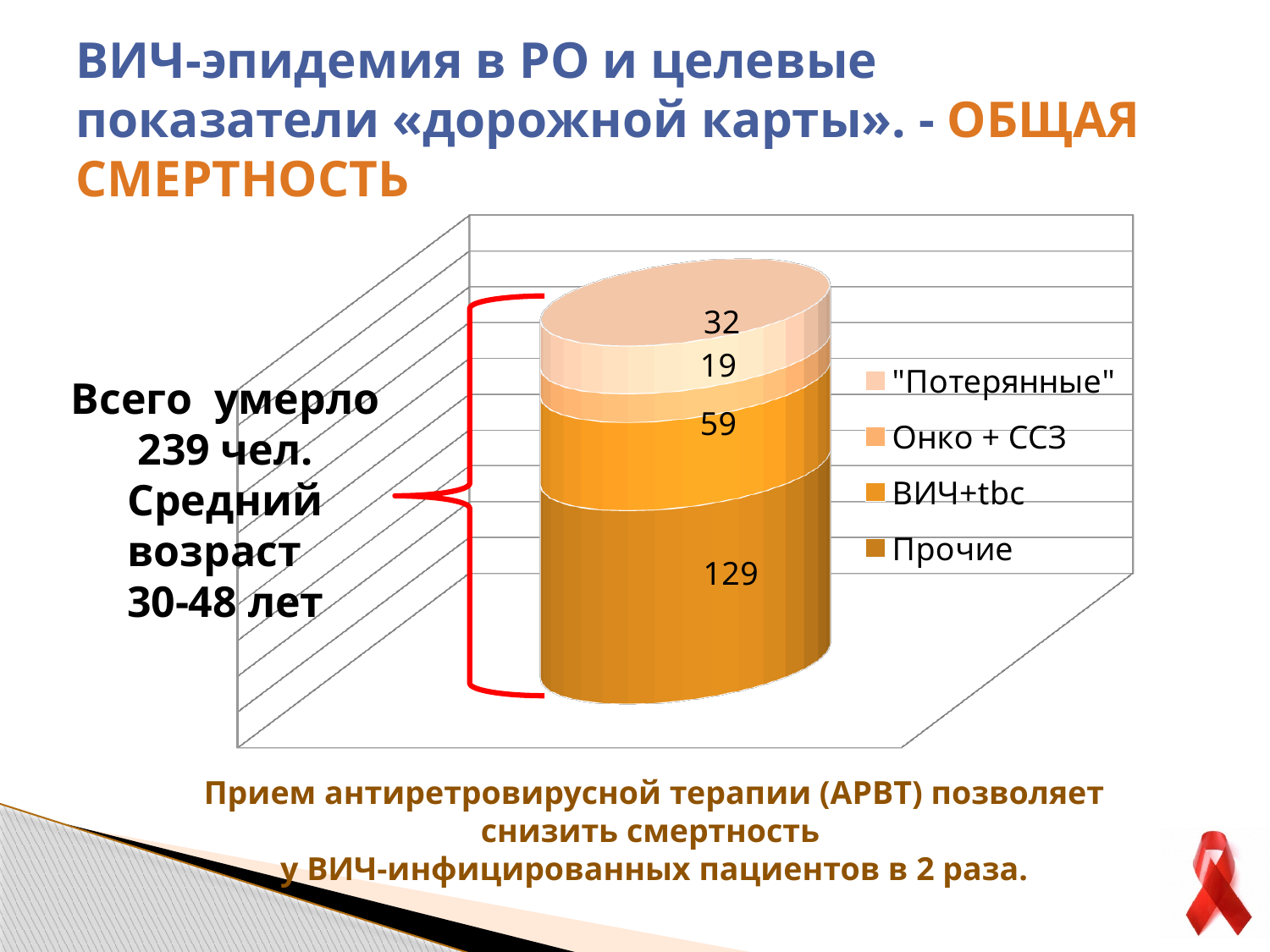
Which is larger, the "ВИЧ+tbc" value or the "Потерянные" value? ВИЧ+tbc What is the difference between the "Прочие" and "ВИЧ+tbc" values? 70 How many series does the legend list? 4 What is the value for the "Онко + ССЗ" segment of the stacked bar? 19 What kind of chart is shown on the slide? Stacked bar chart Which segment of the stacked bar has the smallest value? Онко + ССЗ What is the difference between the "Потерянные" and "Онко + ССЗ" values? 13 What is the total of all segments in the stacked bar? 239 What is the value for the "Потерянные" segment of the stacked bar? 32 What is the value for the "Прочие" segment of the stacked bar? 129 Which segment of the stacked bar has the largest value? Прочие What is the value for the "ВИЧ+tbc" segment of the stacked bar? 59